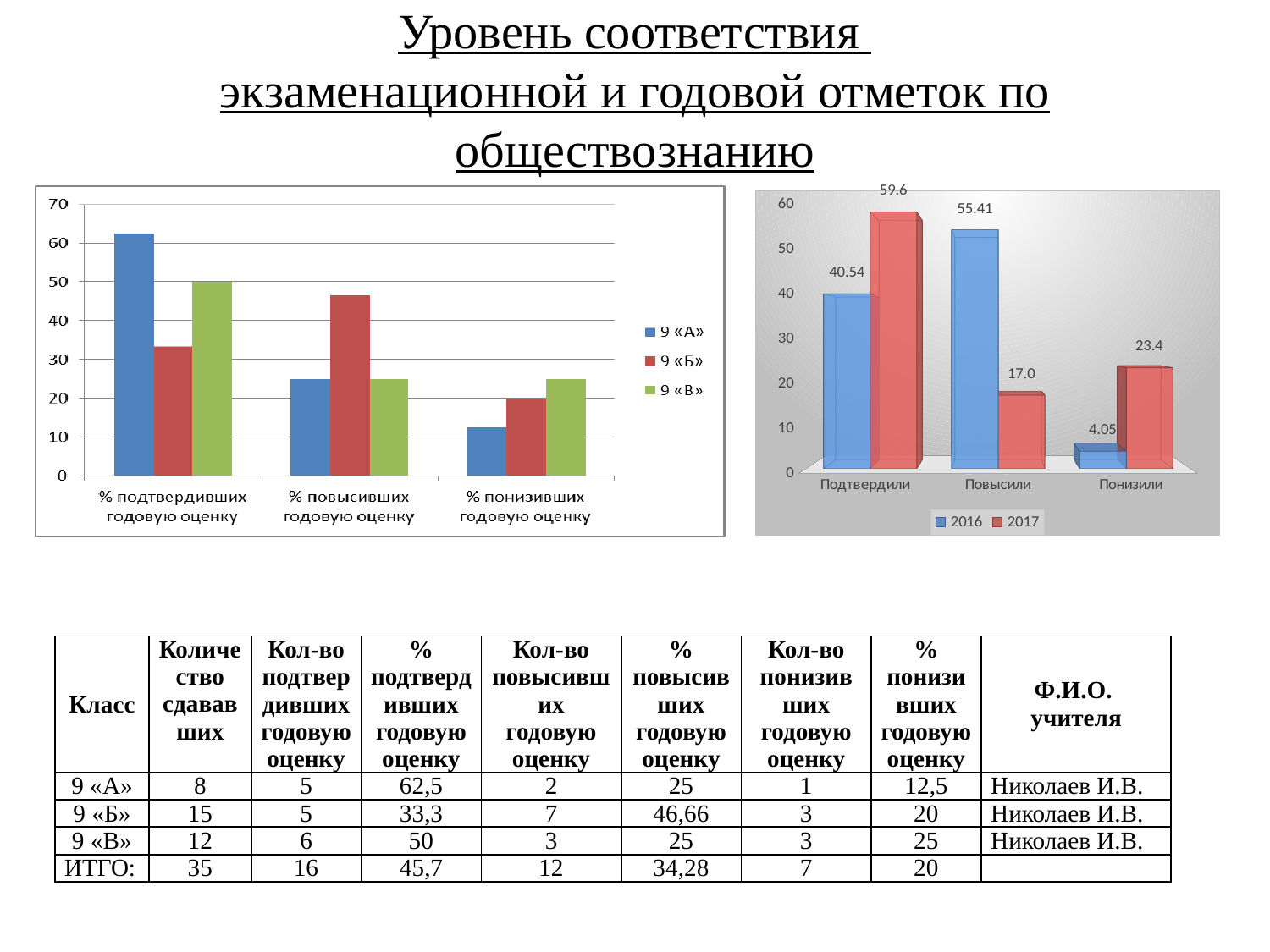
In the left chart, is the value for 9 «А» in % подтвердивших годовую оценку greater or less than 60? greater In the right chart, what is the value for 2017 in the Подтвердили category? 59.6 How many series does the legend of the right chart list? 2 In the right chart, what is the value for 2016 in the Повысили category? 55.41 In the right chart, which is larger for Понизили: the 2016 value or the 2017 value? 2017 What type of chart is the left chart? bar chart In the right chart, which category has the highest value for 2017? Подтвердили In the left chart, which class has the lowest value for % понизивших годовую оценку? 9 «А» In the left chart, which class has the highest value for % повысивших годовую оценку? 9 «Б» In the right chart, what is the difference between the 2016 and 2017 values for Повысили? 38.41 In the right chart, which category has the lowest value for 2016? Понизили In the right chart, what is the value for 2016 in the Понизили category? 4.05